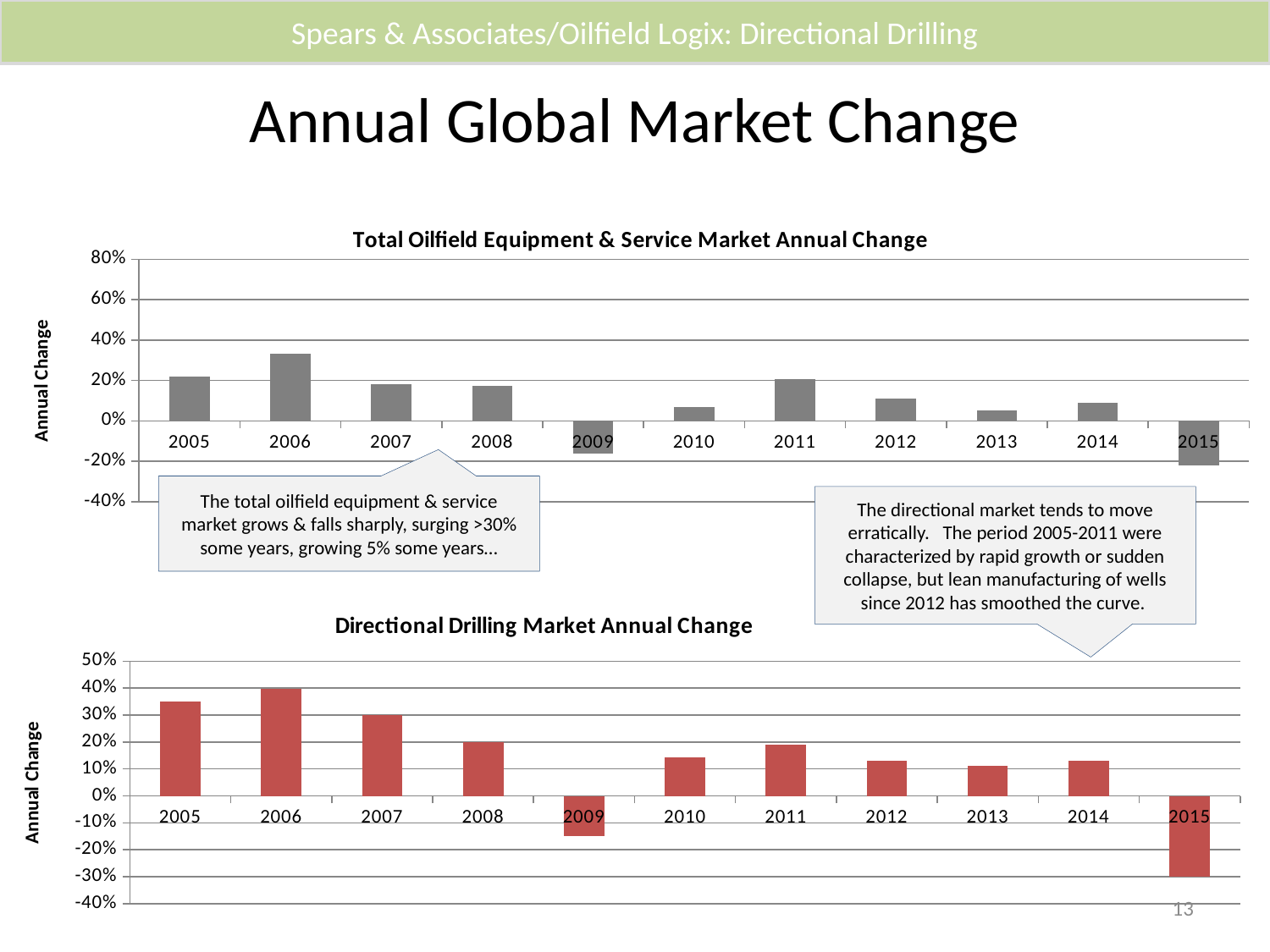
In the "Directional Drilling Market Annual Change" chart, is the value for 2015 greater or less than -20%? less In the "Total Oilfield Equipment & Service Market Annual Change" chart, is the value for 2013 greater or less than 20%? less How many years are shown on the x axis of the "Directional Drilling Market Annual Change" chart? 11 What is the y-axis label of the "Directional Drilling Market Annual Change" chart? Annual Change In the "Total Oilfield Equipment & Service Market Annual Change" chart, which is larger, the value for 2011 or the value for 2013? 2011 In the "Directional Drilling Market Annual Change" chart, which year has the highest value? 2006 In the "Directional Drilling Market Annual Change" chart, which year has the lowest value? 2015 In the "Total Oilfield Equipment & Service Market Annual Change" chart, is the value for 2006 greater or less than 20%? greater In the "Directional Drilling Market Annual Change" chart, which is larger, the value for 2005 or the value for 2008? 2005 In the "Total Oilfield Equipment & Service Market Annual Change" chart, which year has the highest value? 2006 What kind of chart is the "Total Oilfield Equipment & Service Market Annual Change" chart? bar chart In the "Total Oilfield Equipment & Service Market Annual Change" chart, which year has the lowest value? 2015